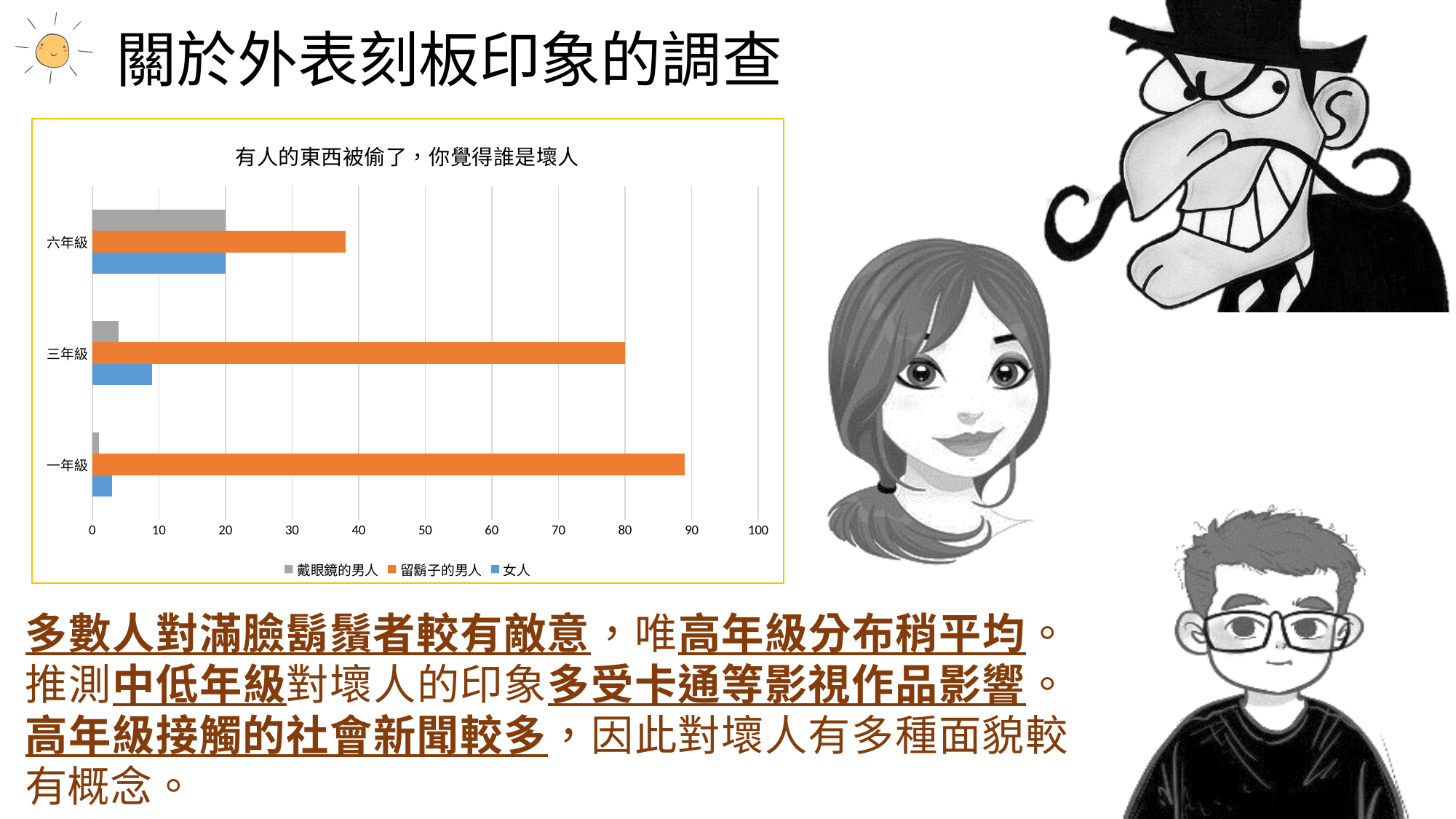
How many series does the chart legend list? 3 What kind of chart is shown on the slide? bar chart Which series is drawn in orange in the chart? 留鬍子的男人 How many grade categories are shown on the chart's vertical axis? 3 What is the value for 留鬍子的男人 in 三年級? 80 Is the value for 留鬍子的男人 in 一年級 greater or less than 80? greater In 六年級, which series has the highest value? 留鬍子的男人 Which grade has the lowest value for 留鬍子的男人? 六年級 What is the title of the chart? 有人的東西被偷了，你覺得誰是壞人 Is the value for 留鬍子的男人 in 六年級 greater or less than 50? less Which grade has the highest value for 留鬍子的男人? 一年級 Which is larger: the value for 女人 in 三年級 or the value for 女人 in 六年級? 六年級